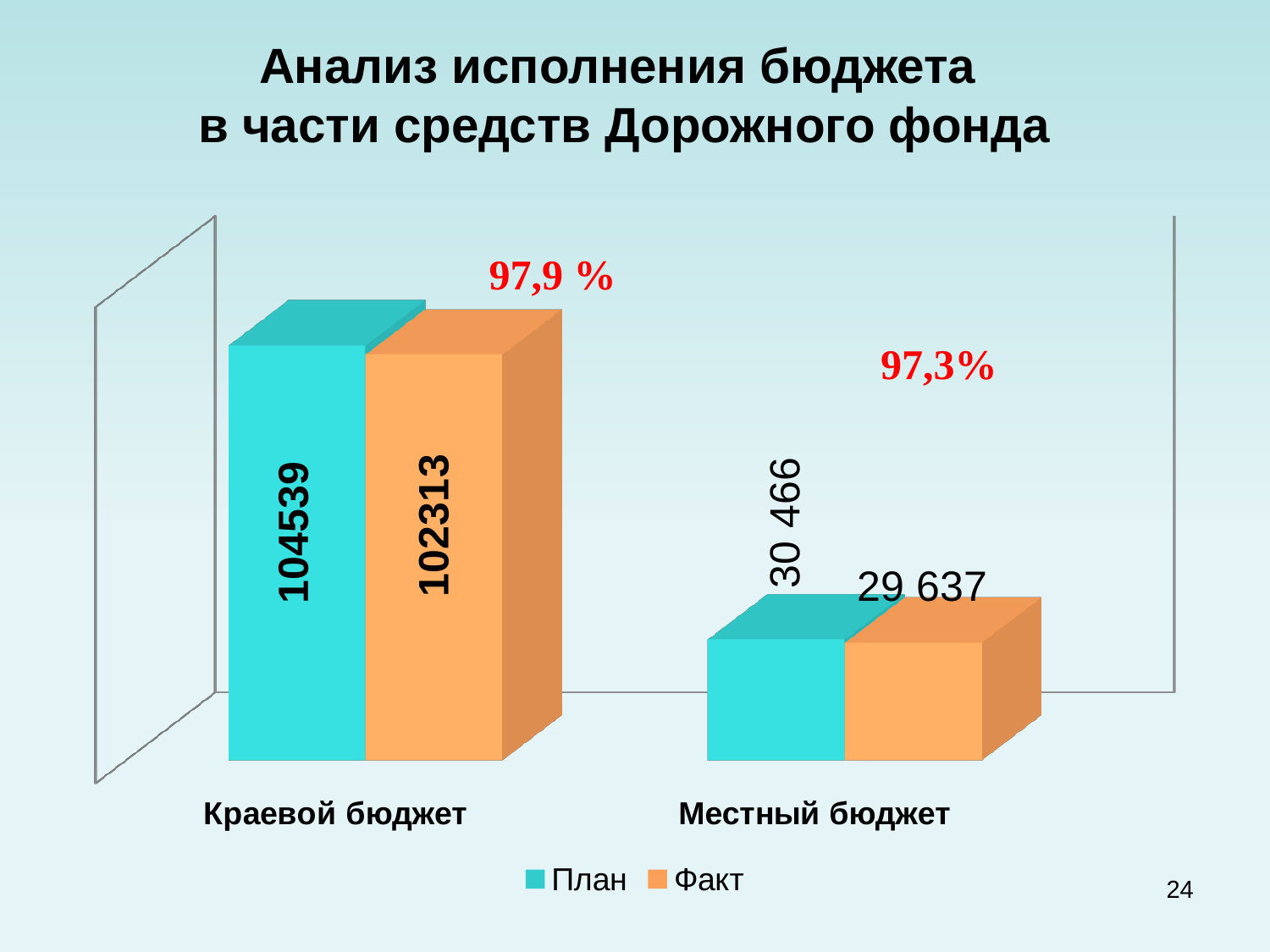
What is the Факт value for Местный бюджет? 29 637 What is the difference between the План and Факт values for Краевой бюджет? 2226 What is the План value for Местный бюджет? 30 466 Which is larger for Местный бюджет, План or Факт? План What is the Факт value for Краевой бюджет? 102313 What kind of chart is shown on the slide? Bar chart How many series does the legend list? 2 What is the План value for Краевой бюджет? 104539 Which category has the lowest Факт value? Местный бюджет How many categories are shown on the x axis? 2 What is the difference between the План and Факт values for Местный бюджет? 829 Which category has the highest План value? Краевой бюджет